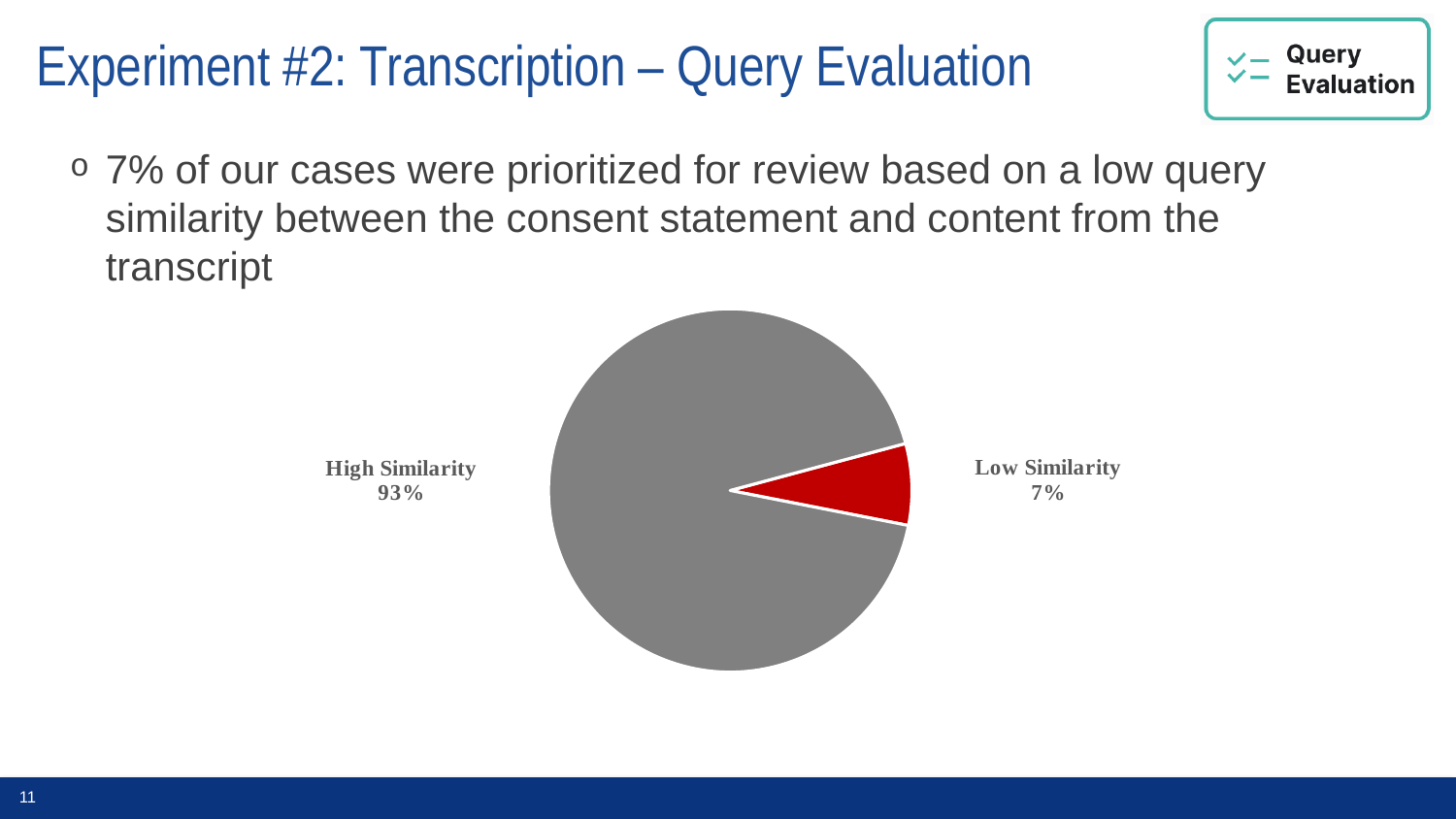
Which is larger, the High Similarity slice or the Low Similarity slice? High Similarity What share of the pie is labelled Low Similarity? 7% Which slice of the pie is the smallest? Low Similarity What kind of chart is shown on the slide? pie chart What is the difference in percentage points between the High Similarity and Low Similarity slices? 86 How many slices does the pie chart have? 2 Which slice of the pie is the largest? High Similarity What colour is the High Similarity slice? grey What share of the pie is labelled High Similarity? 93% What is the total of the two slice percentages shown on the pie chart? 100% What colour is the Low Similarity slice? red